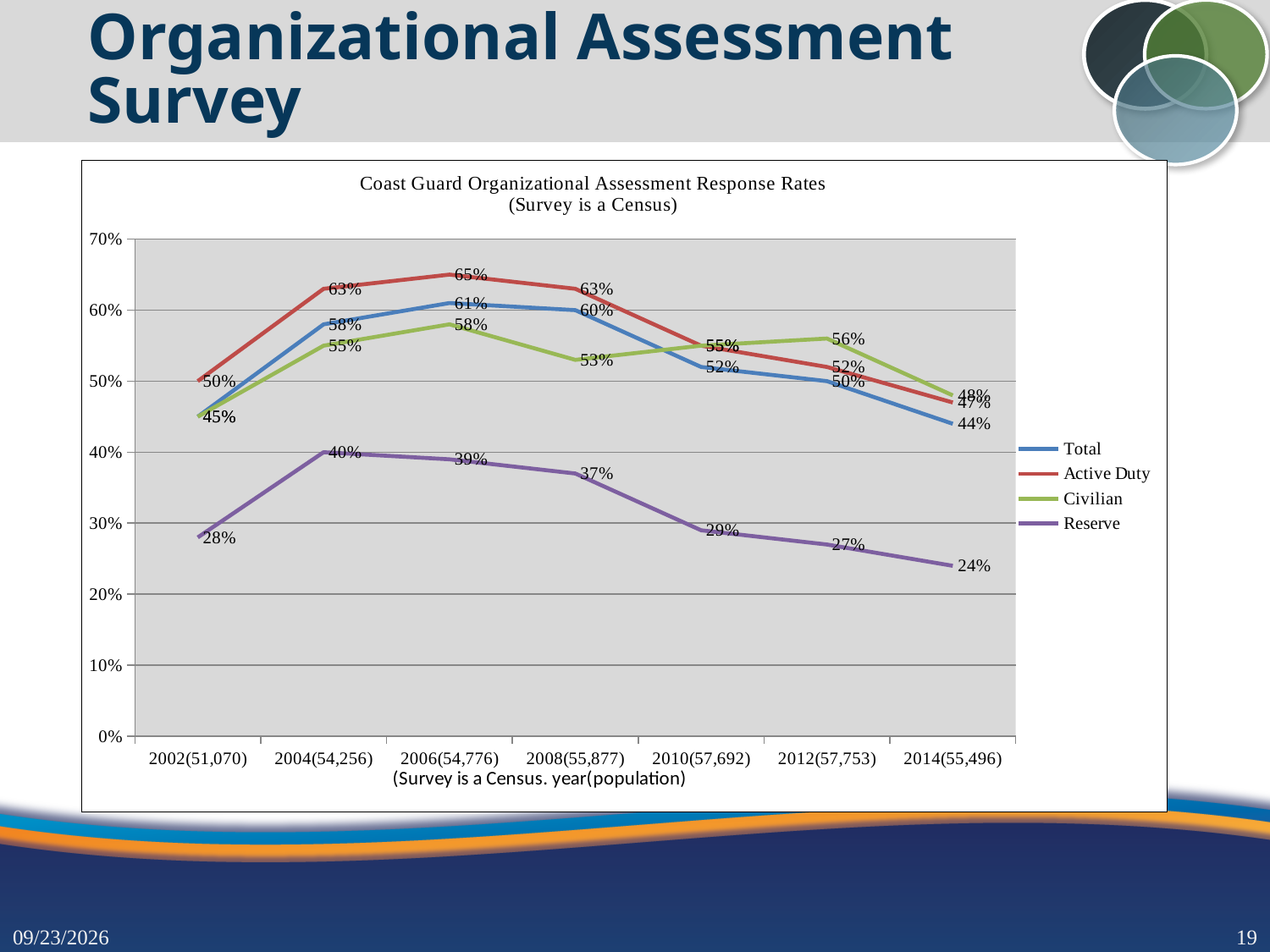
In 2012(57,753), which is larger: the Civilian or the Active Duty response rate? Civilian What is the difference between the Active Duty and Reserve response rates in 2006(54,776)? 26 percentage points What type of chart is shown on the slide? Line chart What is the title of the chart? Coast Guard Organizational Assessment Response Rates (Survey is a Census) What is the Reserve response rate for 2014(55,496)? 24% Does the Reserve response rate rise or fall from 2008(55,877) to 2014(55,496)? Fall In which survey year is the Active Duty response rate highest? 2006(54,776) What is the Active Duty response rate for 2006(54,776)? 65% How many survey years are plotted along the x axis? 7 What is the Civilian response rate for 2012(57,753)? 56% In which survey year is the Reserve response rate lowest? 2014(55,496) How many series does the legend list? 4